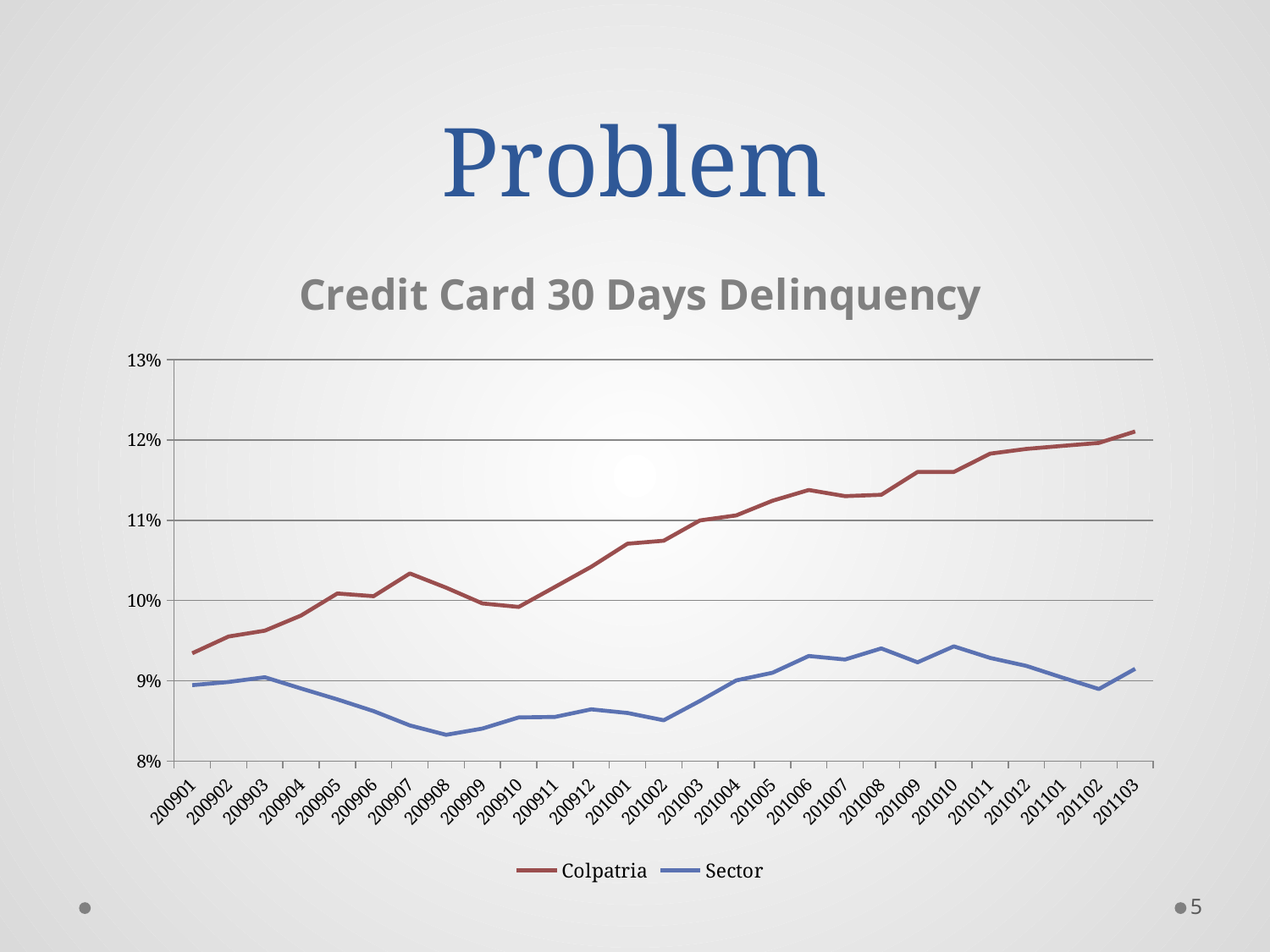
What kind of chart is shown on the slide? line chart Is the Colpatria value for 200901 greater or less than 10%? less Is the Sector value for 200908 greater or less than 9%? less Does the Colpatria line generally rise or fall from 200901 to 201103? rise How many time points are plotted along the x axis? 27 How many series does the legend list? 2 Which colour is used for the Colpatria line? red Is the Colpatria value for 201011 greater or less than 11%? greater At which time point does the Colpatria line reach its highest value? 201103 What is the title of the chart? Credit Card 30 Days Delinquency At which time point does the Sector line reach its lowest value? 200908